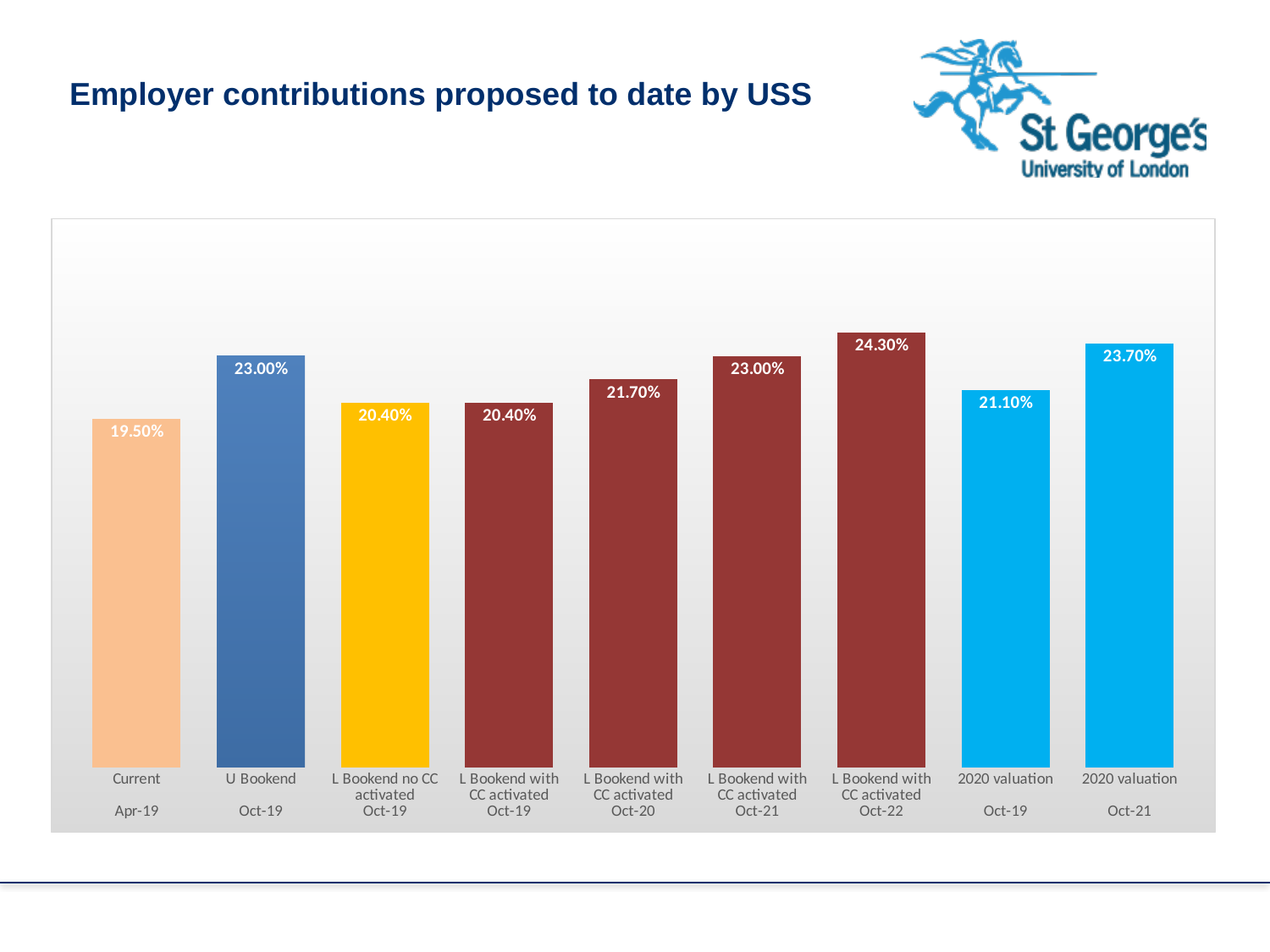
Which is larger: the value for L Bookend with CC activated Oct-20 or the value for 2020 valuation Oct-19? L Bookend with CC activated Oct-20 What is the difference between the 2020 valuation Oct-21 value and the 2020 valuation Oct-19 value? 2.60% What is the difference between the L Bookend with CC activated Oct-22 value and the Current Apr-19 value? 4.80% What is the employer contribution for Current (Apr-19)? 19.50% What is the value for L Bookend with CC activated in Oct-22? 24.30% Which bar has the lowest value? Current Apr-19 What is the value for U Bookend (Oct-19)? 23.00% What is the title of the slide? Employer contributions proposed to date by USS What is the value for 2020 valuation (Oct-21)? 23.70% Which bar has the highest value? L Bookend with CC activated Oct-22 How many bars are shown in the chart? 9 What kind of chart is shown on the slide? Bar chart